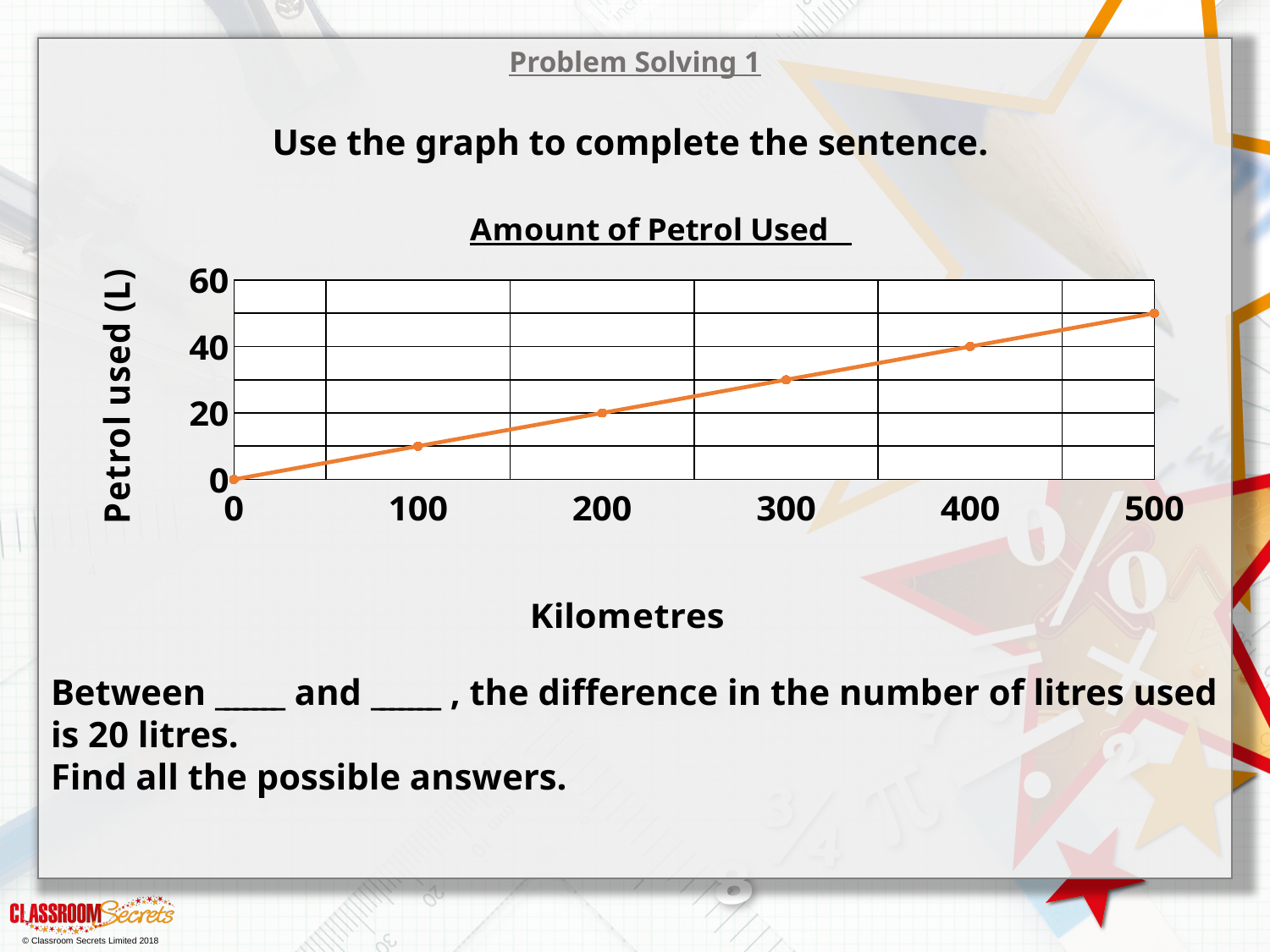
Is the value for 100 kilometres greater or less than 20? less How many litres of petrol are used at 200 kilometres? 20 Which has a higher petrol used value, 200 kilometres or 400 kilometres? 400 kilometres What kind of chart is shown on the slide? line chart Is the value for 500 kilometres greater or less than 40? greater What is the difference in litres used between 200 kilometres and 400 kilometres? 20 How many litres of petrol are used at 400 kilometres? 40 What is the label on the vertical axis of the chart? Petrol used (L) What is the title of the chart? Amount of Petrol Used Is the value for 300 kilometres greater or less than 40? less How many litres of petrol are used at 0 kilometres? 0 Does the petrol used rise or fall as the kilometres increase? rise